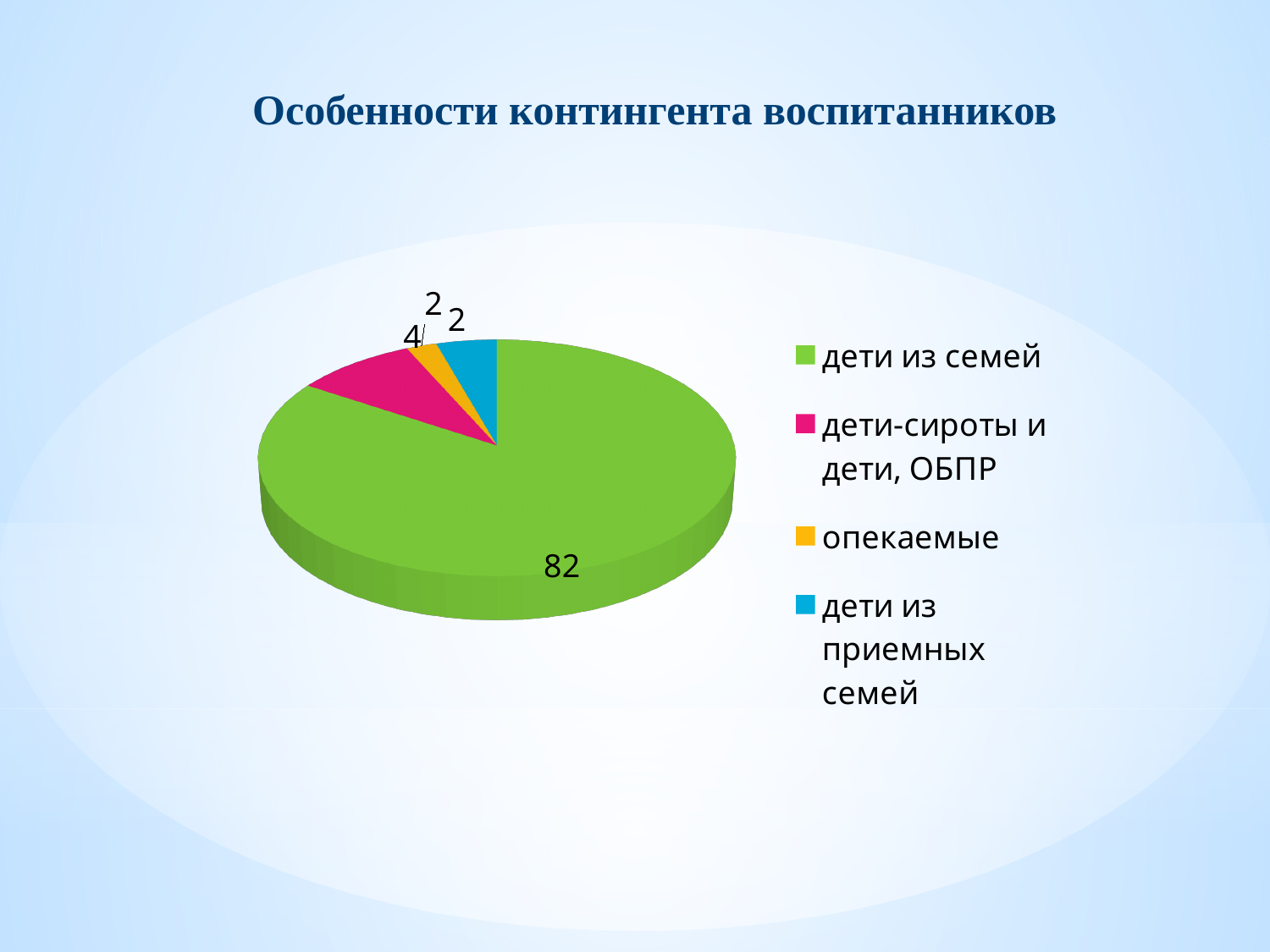
What is the title of the slide? Особенности контингента воспитанников What is the difference between the values for "дети из семей" and "дети-сироты и дети, ОБПР"? 78 What colour is the slice for "дети из семей"? green How many slices does the pie chart have? 4 What is the value for the slice "опекаемые"? 2 What kind of chart is shown on the slide? pie chart What is the value for the slice "дети из семей"? 82 How many entries does the legend list? 4 What is the value for the slice "дети-сироты и дети, ОБПР"? 4 Which category has the largest slice of the pie? дети из семей What is the value for the slice "дети из приемных семей"? 2 Which is larger: the value for "дети-сироты и дети, ОБПР" or the value for "опекаемые"? дети-сироты и дети, ОБПР